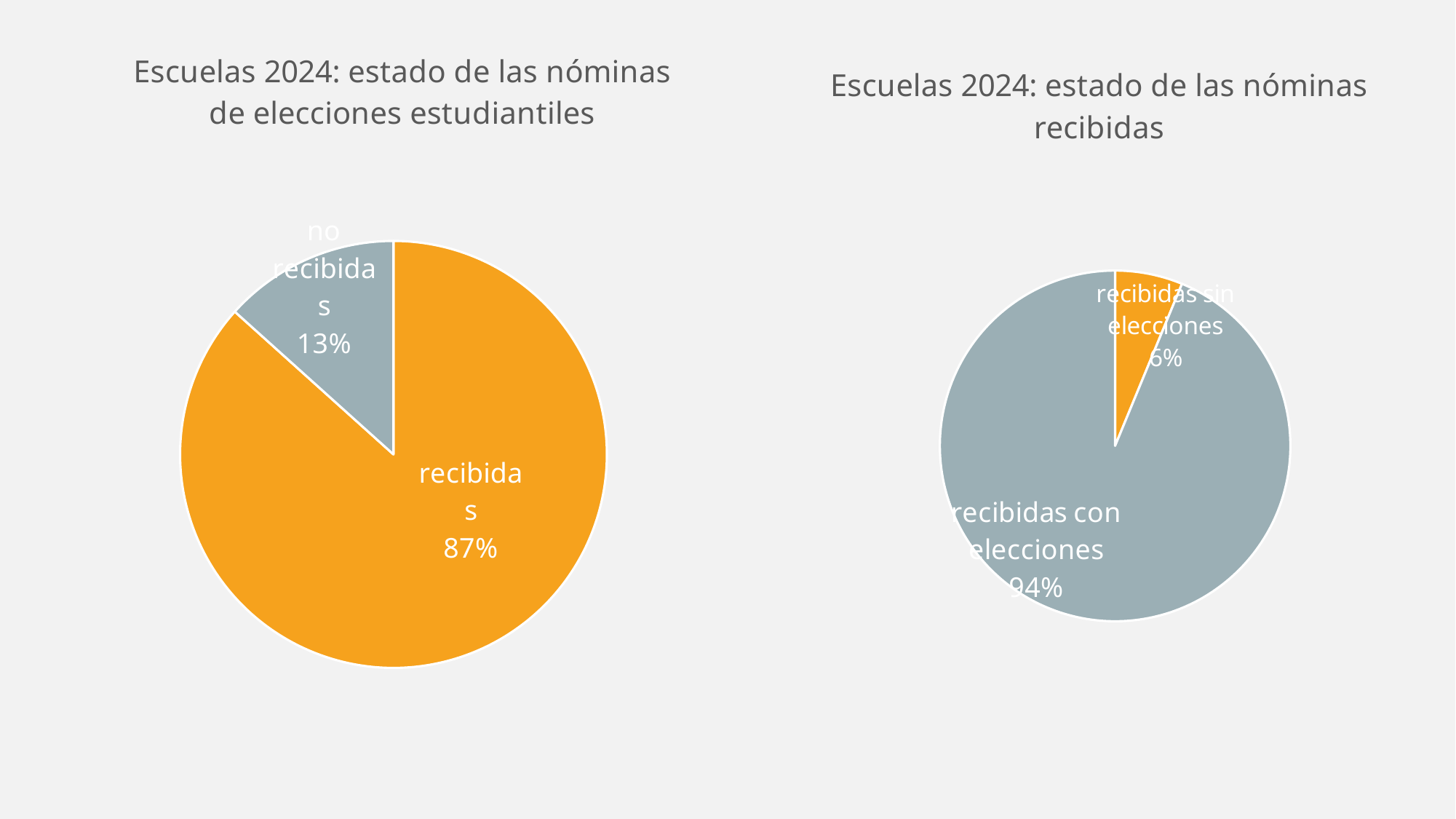
In the right chart, what is the difference in percentage points between 'recibidas con elecciones' and 'recibidas sin elecciones'? 88 In the right chart, which slice is the smallest? recibidas sin elecciones In the chart titled 'Escuelas 2024: estado de las nóminas de elecciones estudiantiles', what share of the pie is 'recibidas'? 87% In the chart titled 'Escuelas 2024: estado de las nóminas de elecciones estudiantiles', what share of the pie is 'no recibidas'? 13% In the left chart, which slice is the largest? recibidas In the chart titled 'Escuelas 2024: estado de las nóminas recibidas', what share of the pie is 'recibidas con elecciones'? 94% In the left chart, what colour is the 'recibidas' slice? orange What kind of chart is the left chart? pie chart In the right chart, which is larger: 'recibidas con elecciones' or 'recibidas sin elecciones'? recibidas con elecciones How many slices does the right chart have? 2 In the left chart, what is the difference in percentage points between 'recibidas' and 'no recibidas'? 74